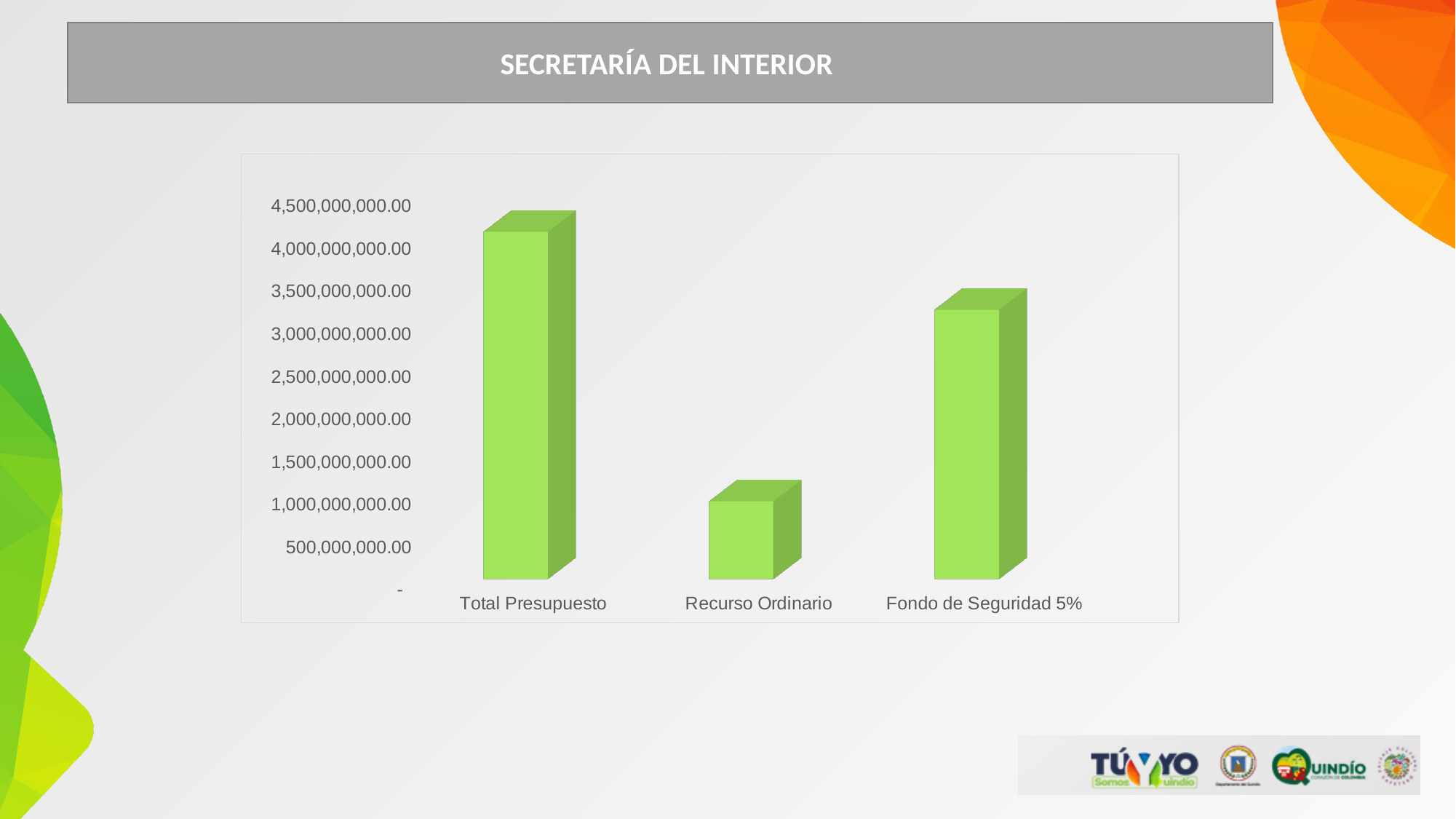
Which is larger, the value for Fondo de Seguridad 5% or the value for Recurso Ordinario? Fondo de Seguridad 5% Which category has the highest value in the chart? Total Presupuesto What is the title shown in the header above the chart? SECRETARÍA DEL INTERIOR Which is larger, the value for Total Presupuesto or the value for Fondo de Seguridad 5%? Total Presupuesto Is the value for Total Presupuesto greater or less than 4,000,000,000.00? greater What kind of chart is shown on the slide? bar chart How many categories are shown on the x axis of the chart? 3 Is the value for Fondo de Seguridad 5% greater or less than 3,000,000,000.00? greater What colour are the bars in the chart? green Is the value for Recurso Ordinario greater or less than 1,500,000,000.00? less Which category has the lowest value in the chart? Recurso Ordinario